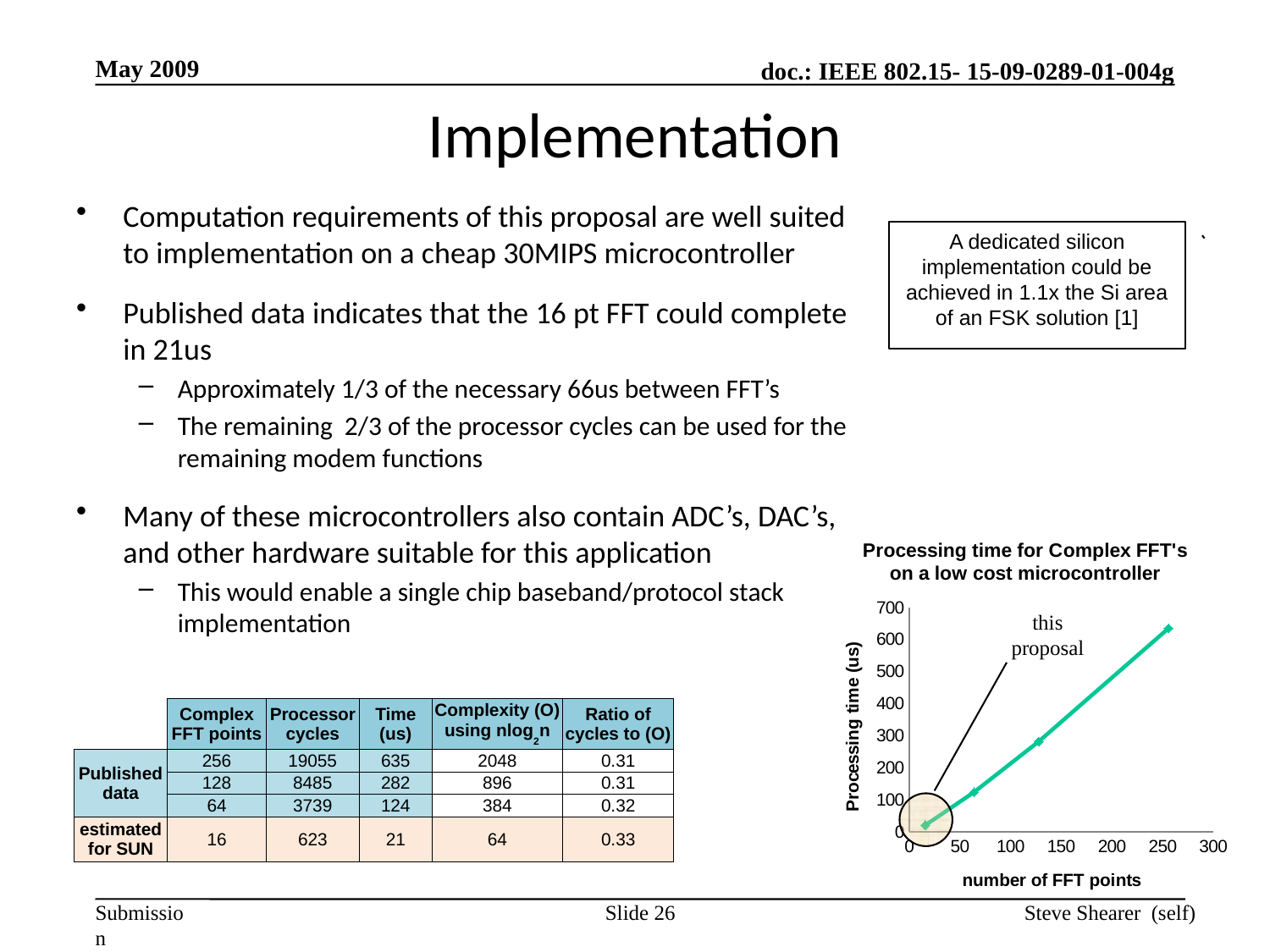
What is the label of the x axis of the chart? number of FFT points How many data points are plotted on the chart? 4 Is the processing time for 16 FFT points greater or less than 100 us? less Is the processing time for 64 FFT points greater or less than 200 us? less Does the processing time rise or fall as the number of FFT points increases? rises Is the processing time for 128 FFT points greater or less than 200 us? greater What kind of chart is shown on the slide? line chart What is the title of the chart on the slide? Processing time for Complex FFT's on a low cost microcontroller At which number of FFT points is the processing time lowest? 16 Which has the larger processing time on the chart, 128 FFT points or 64 FFT points? 128 FFT points At which number of FFT points is the processing time highest? 256